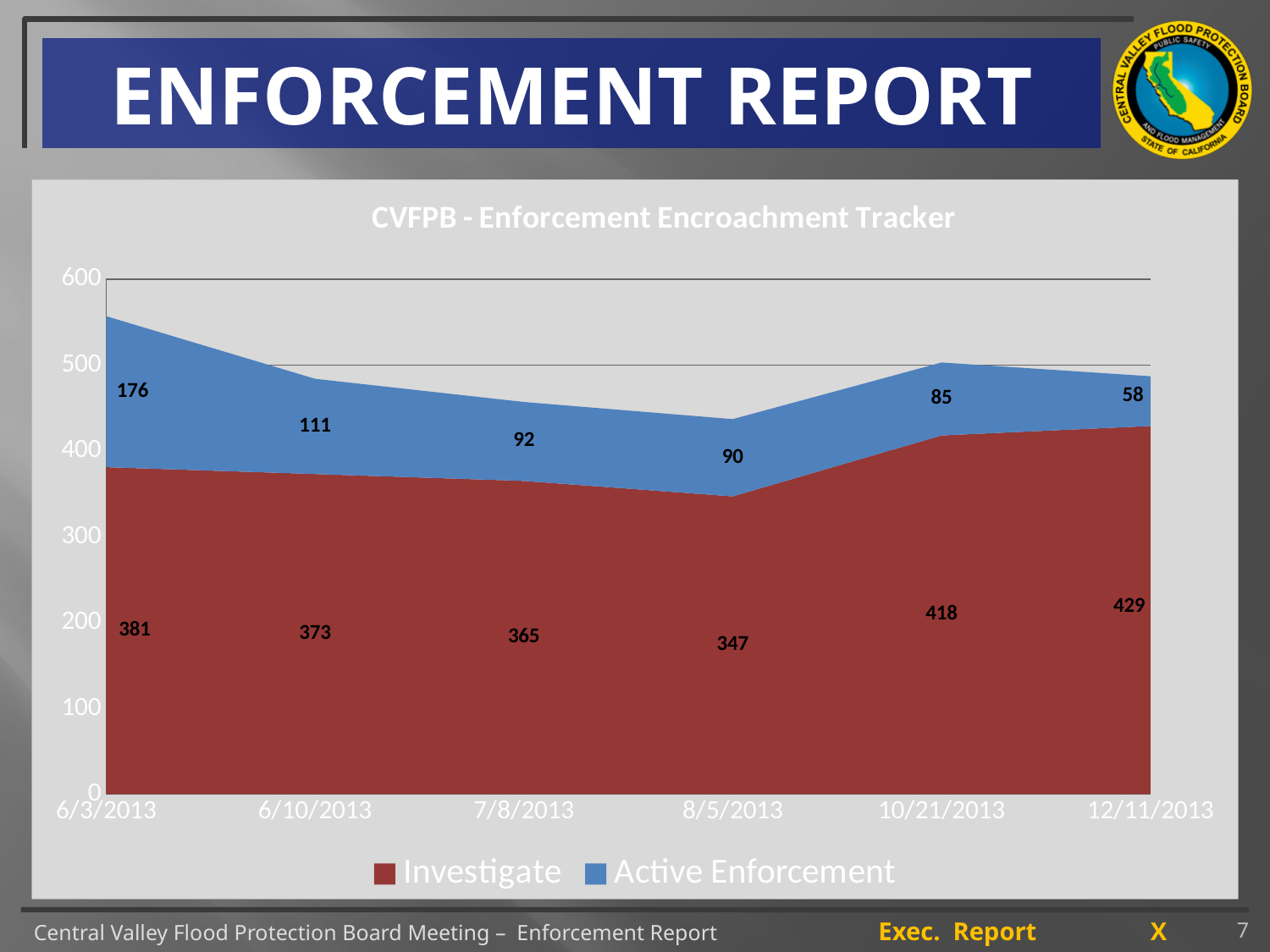
What is the Investigate value on 8/5/2013? 347 Which is larger, the Active Enforcement value on 6/10/2013 or on 7/8/2013? 6/10/2013 How many series does the legend list? 2 What is the Active Enforcement value on 10/21/2013? 85 What is the difference between the Investigate values on 12/11/2013 and 6/3/2013? 48 What is the title of the chart? CVFPB - Enforcement Encroachment Tracker On which date is the Active Enforcement value highest? 6/3/2013 What is the total of Investigate and Active Enforcement on 12/11/2013? 487 What is the Investigate value on 6/3/2013? 381 On which date is the Investigate value lowest? 8/5/2013 How many dates are shown on the x axis? 6 What kind of chart is shown? Stacked area chart